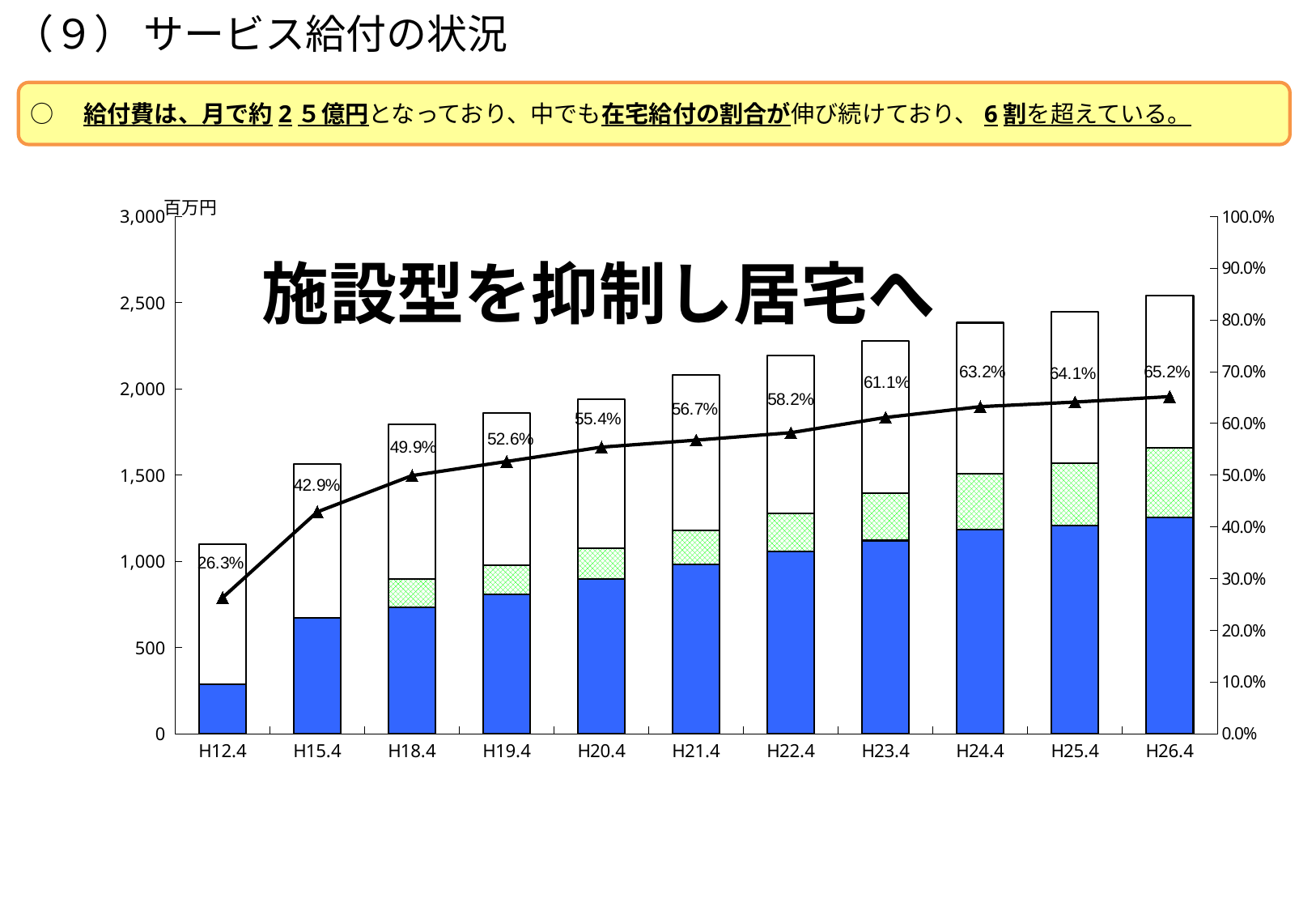
Which has a higher line percentage, H18.4 or H21.4? H21.4 Is the total height of the stacked bar for H12.4 greater or less than 1,000? greater What is the difference in percentage points between the line values for H26.4 and H12.4? 38.9 What percentage does the line series show for H12.4? 26.3% Which category has the highest percentage on the line series? H26.4 How many categories are shown on the x axis? 11 What percentage does the line series show for H26.4? 65.2% Is the total height of the stacked bar for H20.4 greater or less than 2,000? less Does the line series rise or fall from H12.4 to H26.4? rise What percentage does the line series show for H22.4? 58.2% Which category has the lowest percentage on the line series? H12.4 What unit is shown at the top of the left axis? 百万円